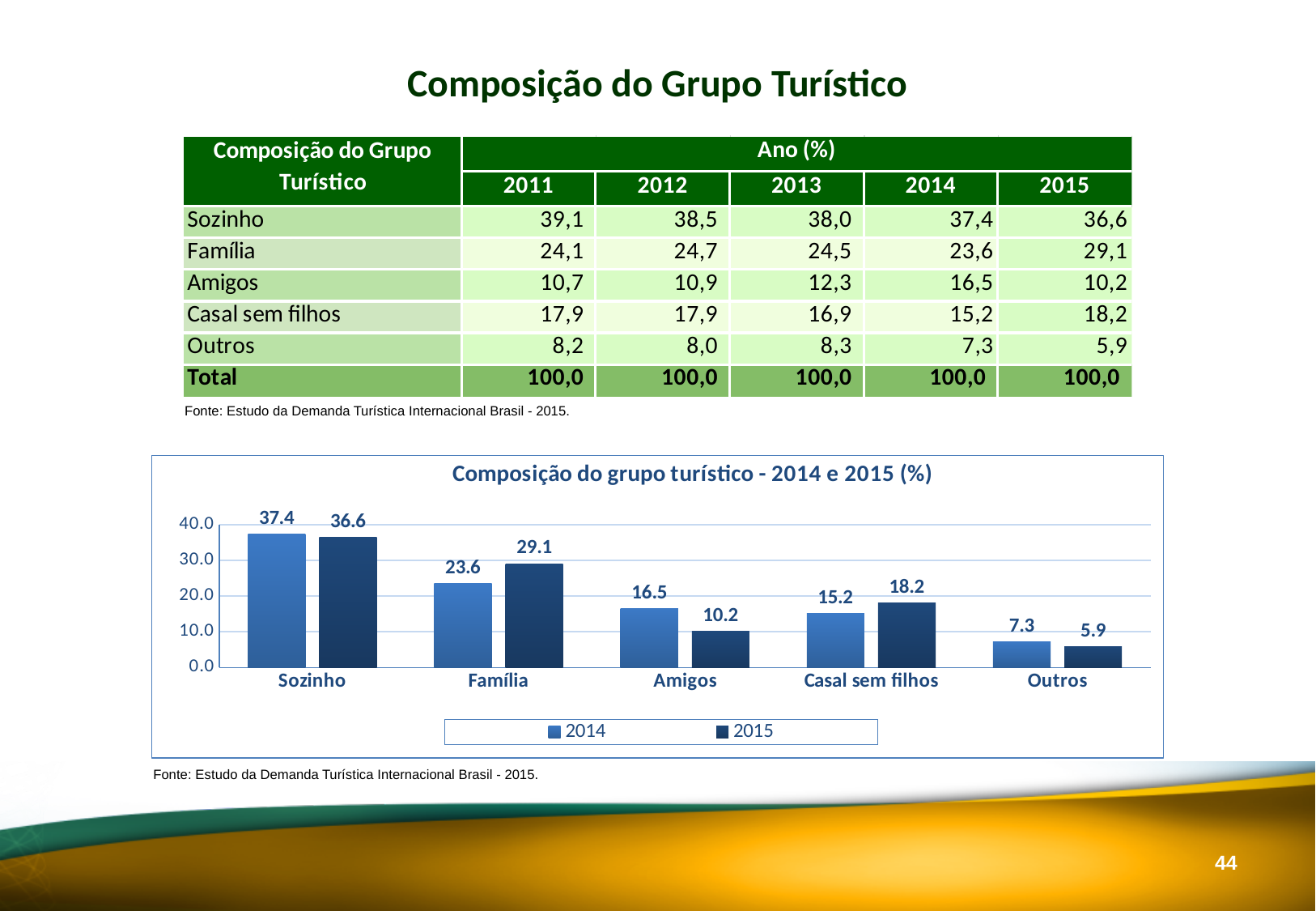
What is the difference between the 2014 and 2015 values for Amigos in the chart? 6.3 Which category has the highest value for 2015 in the chart? Sozinho How many series does the chart's legend list? 2 Which is larger in the chart: Casal sem filhos in 2014 or Casal sem filhos in 2015? Casal sem filhos in 2015 What is the value for Sozinho in 2014 in the chart? 37.4 Which category has the lowest value for 2014 in the chart? Outros What is the title of the chart? Composição do grupo turístico - 2014 e 2015 (%) What kind of chart is shown on the slide? Bar chart What is the value for Família in 2015 in the chart? 29.1 How many categories are shown on the x axis of the chart? 5 What is the value for Outros in 2015 in the chart? 5.9 What is the difference between the 2015 and 2014 values for Família in the chart? 5.5